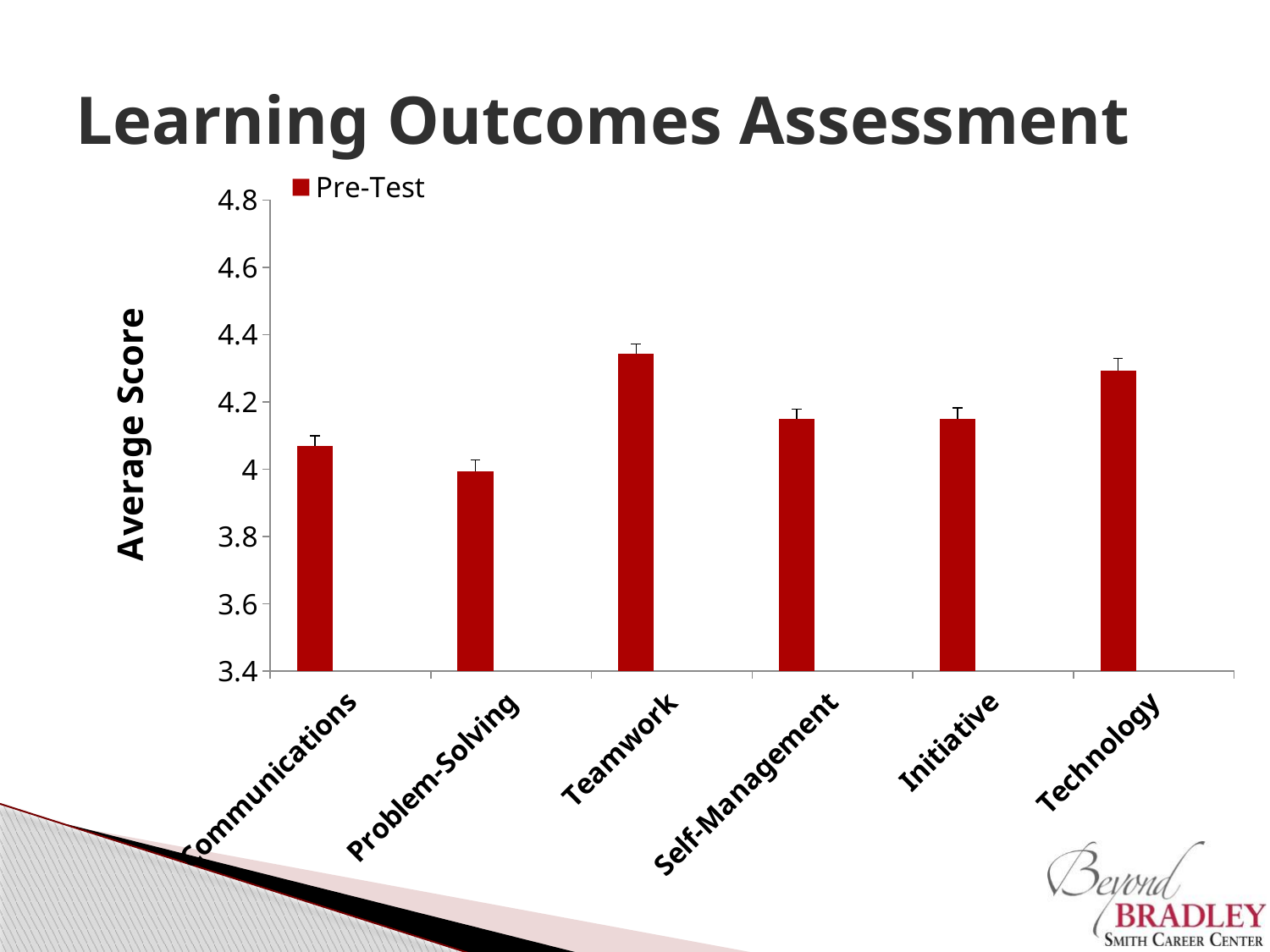
Is the value for Communications greater or less than 4? greater What kind of chart is shown on the slide? bar chart What is the label on the vertical axis of the chart? Average Score Is the value for Teamwork greater or less than 4.2? greater Is the value for Initiative greater or less than 4.2? less Which has a higher average score, Teamwork or Communications? Teamwork Which category has the highest average score? Teamwork How many series does the legend list? 1 Which has a higher average score, Technology or Problem-Solving? Technology How many categories are plotted on the x axis? 6 Which category has the lowest average score? Problem-Solving